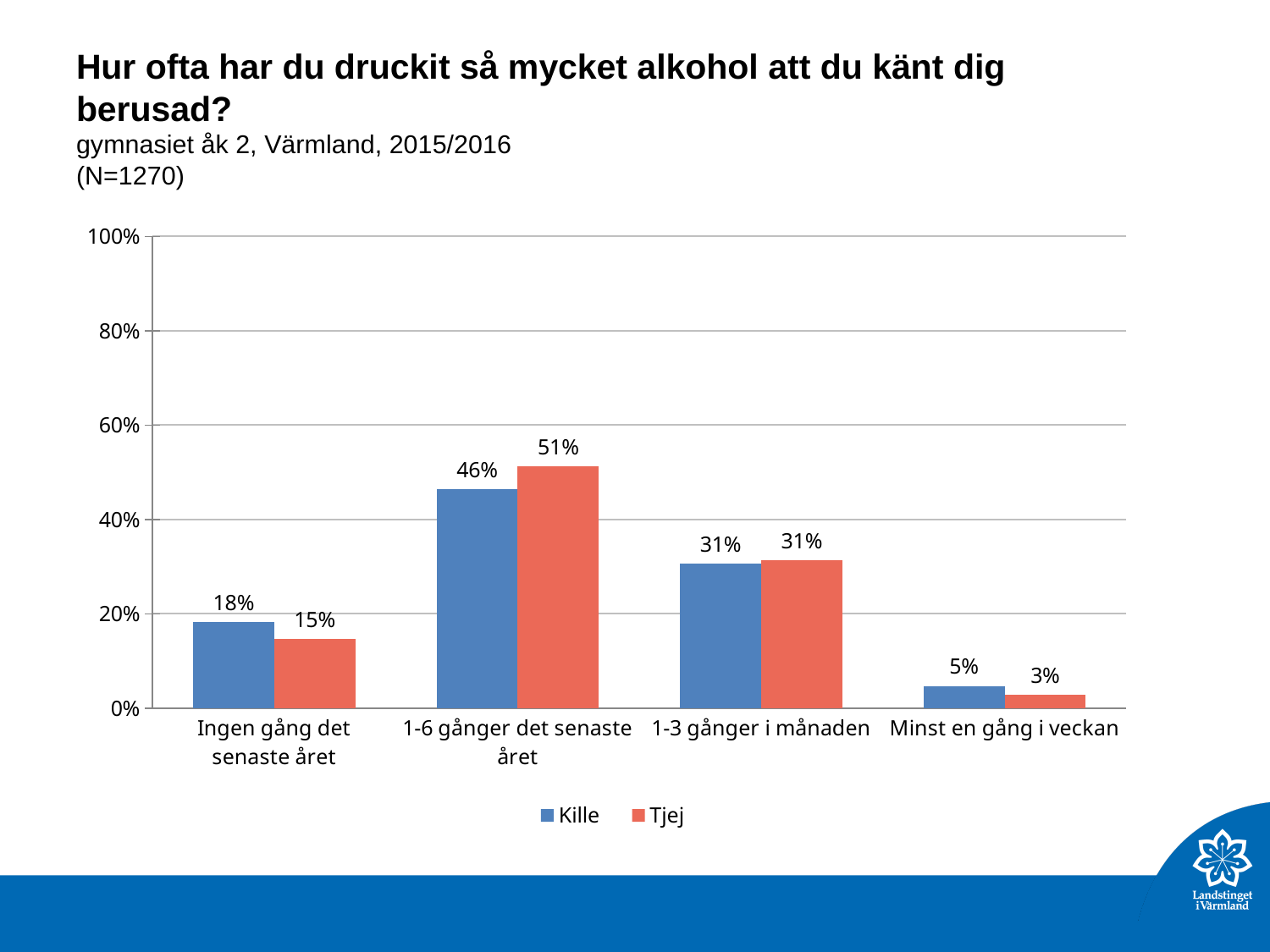
What is the sample size (N) stated on the slide? N=1270 Is the value for Kille in "1-3 gånger i månaden" greater or less than 40%? less How many categories are shown on the x axis? 4 Which category has the highest value for Tjej? 1-6 gånger det senaste året What kind of chart is shown on the slide? bar chart Which category has the lowest value for Kille? Minst en gång i veckan What is the value for Tjej in the category "Minst en gång i veckan"? 3% In the category "Ingen gång det senaste året", which series has the larger value, Kille or Tjej? Kille What is the value for Kille in the category "1-6 gånger det senaste året"? 46% What is the difference between the Tjej and Kille values in the category "1-6 gånger det senaste året"? 5% How many series does the legend list? 2 What is the value for Tjej in the category "Ingen gång det senaste året"? 15%